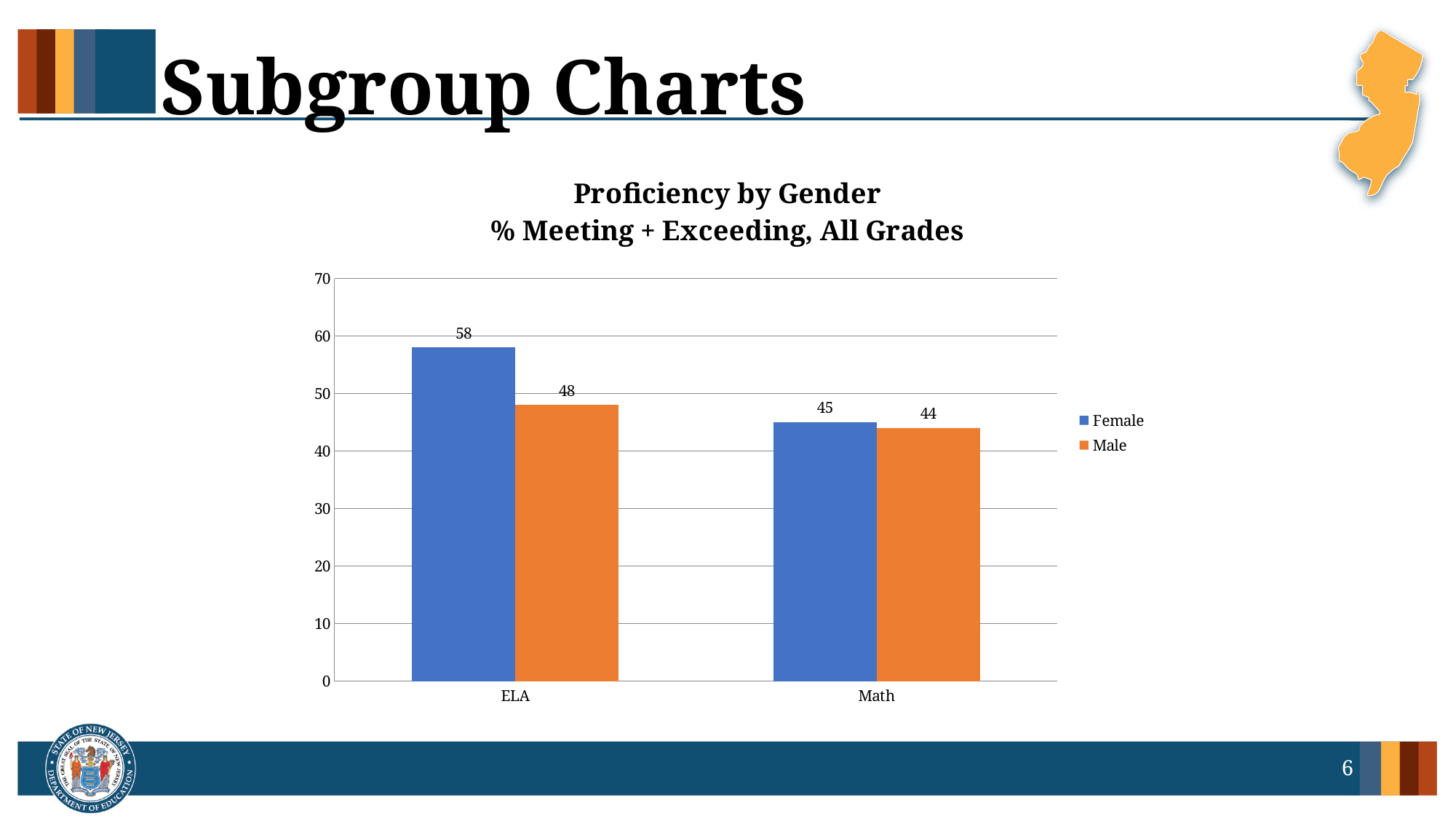
How many series does the legend list? 2 Which subject has the highest Female value? ELA What is the difference between the Female and Male values for ELA? 10 Is the Female value for ELA greater or less than 50? greater What is the Female value for ELA? 58 What kind of chart is shown on the slide? Bar chart What is the Female value for Math? 45 What is the Male value for Math? 44 Which subject has the lowest Male value? Math How many subject categories are shown on the x axis? 2 What is the Male value for ELA? 48 Which is larger for ELA, the Female value or the Male value? Female